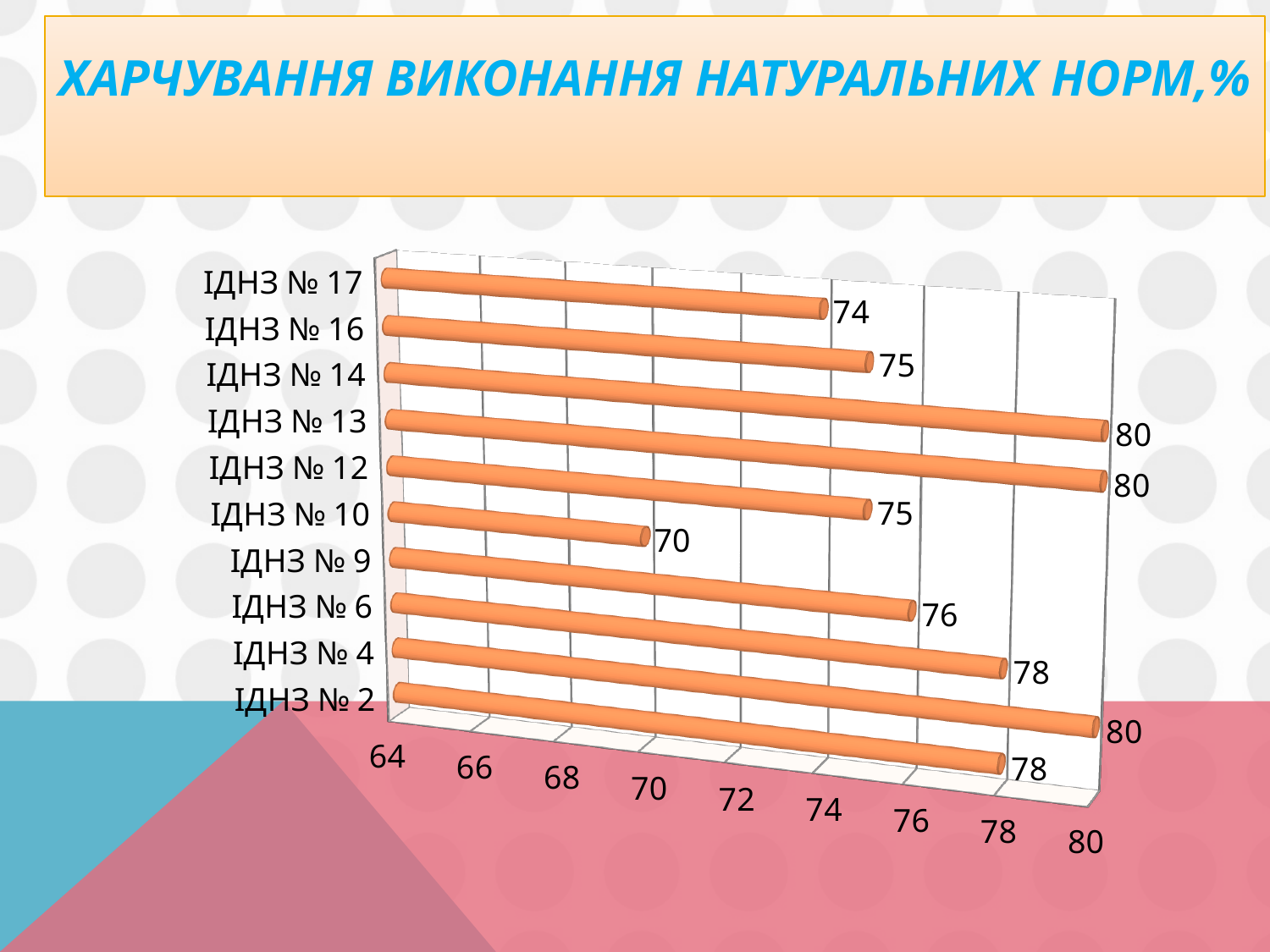
What is the value for ІДНЗ № 17? 74 Is the value for ІДНЗ № 9 greater or less than 72? greater What is the value for ІДНЗ № 13? 80 Which is larger, the value for ІДНЗ № 2 or the value for ІДНЗ № 12? ІДНЗ № 2 What is the difference between the values for ІДНЗ № 6 and ІДНЗ № 16? 3 What is the value for ІДНЗ № 10? 70 How many categories are shown in the chart? 10 What is the difference between the values for ІДНЗ № 4 and ІДНЗ № 10? 10 What kind of chart is shown on the slide? bar chart What is the value for ІДНЗ № 9? 76 Which category has the lowest value? ІДНЗ № 10 What is the title of the chart on the slide? ХАРЧУВАННЯ ВИКОНАННЯ НАТУРАЛЬНИХ НОРМ,%